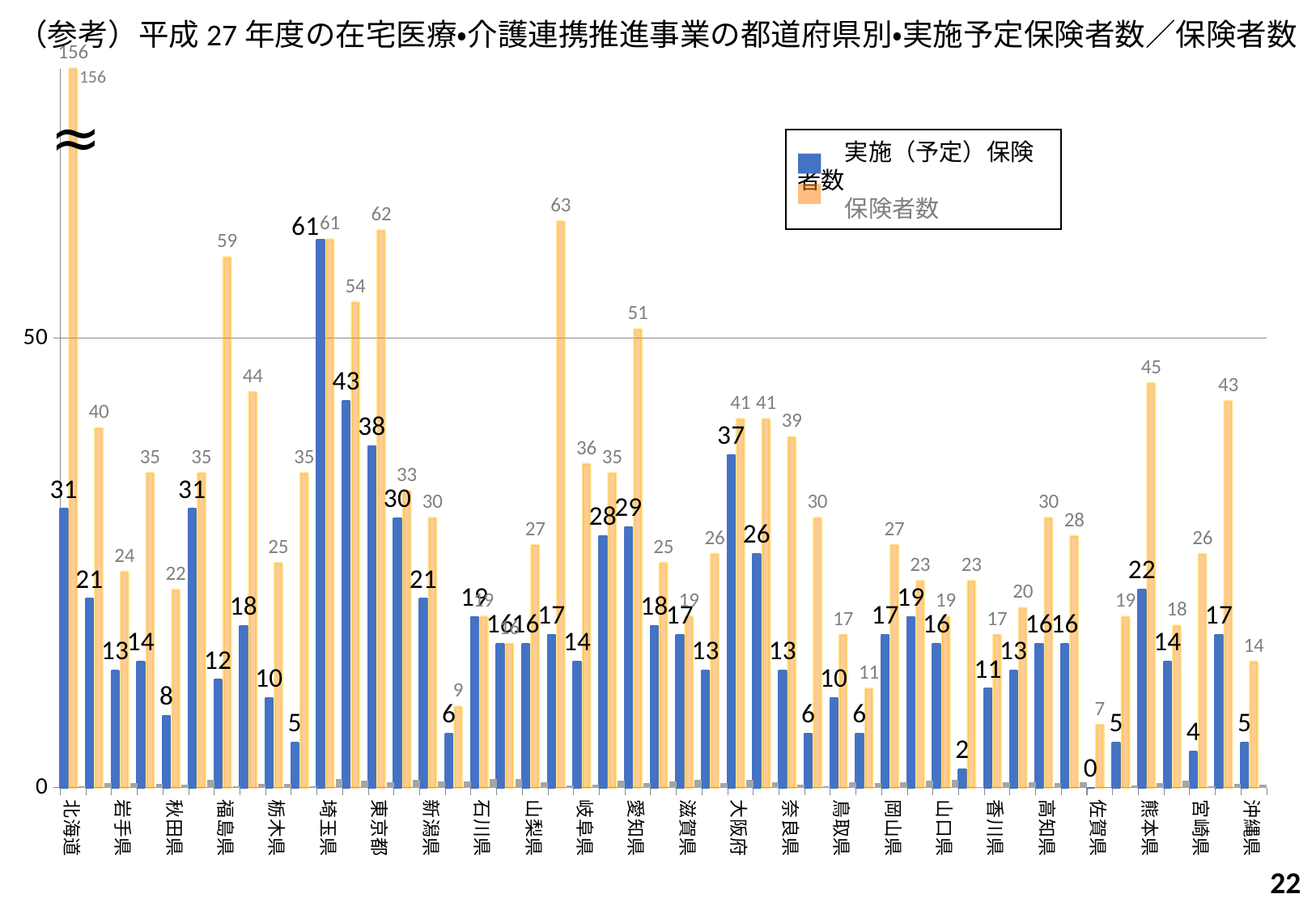
What is the 保険者数 value for 愛知県? 51 What is the 実施（予定）保険者数 value for 埼玉県? 61 What is the 実施（予定）保険者数 value for 大阪府? 37 Which labeled prefecture has the lowest 実施（予定）保険者数 value? 佐賀県 What is the 保険者数 value for 北海道? 156 What is the difference between the 保険者数 and the 実施（予定）保険者数 for 福島県? 47 Is the 保険者数 value for 東京都 greater or less than 50? greater Which labeled prefecture has the highest 実施（予定）保険者数 value? 埼玉県 What is the difference between the 保険者数 and the 実施（予定）保険者数 for 東京都? 24 How many series does the legend list? 2 Which is larger, the 実施（予定）保険者数 for 熊本県 or for 宮崎県? 熊本県 What kind of chart is shown on the slide? bar chart